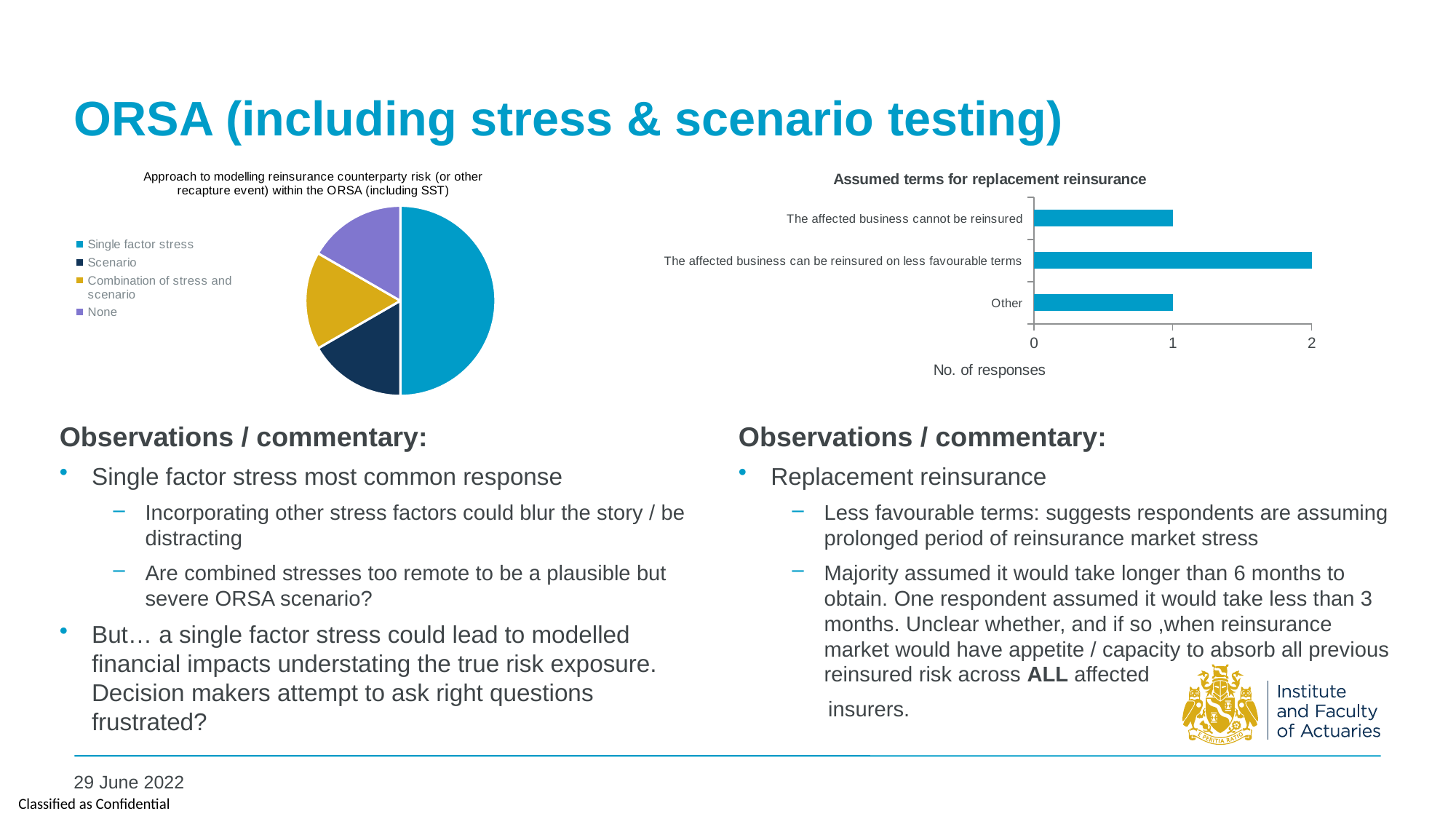
How many categories does the legend of the pie chart on the left list? 4 In the 'Assumed terms for replacement reinsurance' chart, what is the label on the horizontal axis? No. of responses What kind of chart is the 'Assumed terms for replacement reinsurance' chart? Bar chart In the 'Assumed terms for replacement reinsurance' chart, how many responses are there for 'Other'? 1 In the 'Assumed terms for replacement reinsurance' chart, what is the difference in responses between 'The affected business can be reinsured on less favourable terms' and 'Other'? 1 What kind of chart is the 'Approach to modelling reinsurance counterparty risk' chart on the left? Pie chart In the 'Assumed terms for replacement reinsurance' chart, which has more responses: 'The affected business cannot be reinsured' or 'The affected business can be reinsured on less favourable terms'? The affected business can be reinsured on less favourable terms In the 'Assumed terms for replacement reinsurance' chart, how many categories are shown? 3 In the 'Assumed terms for replacement reinsurance' chart, which category has the most responses? The affected business can be reinsured on less favourable terms In the 'Assumed terms for replacement reinsurance' chart, how many responses are there for 'The affected business can be reinsured on less favourable terms'? 2 In the 'Assumed terms for replacement reinsurance' chart, how many responses are there for 'The affected business cannot be reinsured'? 1 In the pie chart on the left, which category has the largest share? Single factor stress